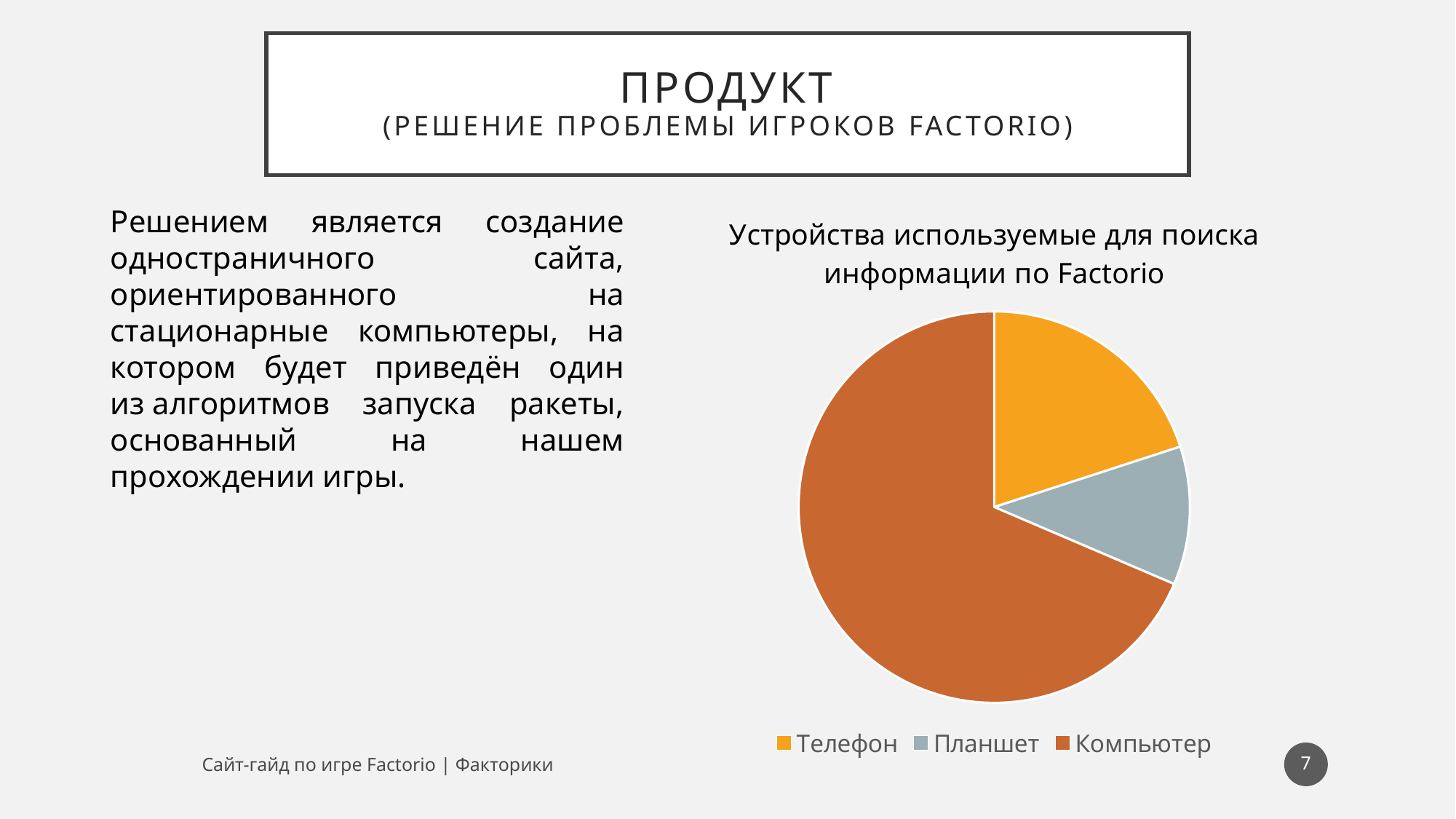
Which colour represents Компьютер in the pie chart? Brown/orange-brown Which category has the largest slice of the pie? Компьютер Which slice is larger, Компьютер or Телефон? Компьютер Which slice is larger, Телефон or Планшет? Телефон What is the title of the chart? Устройства используемые для поиска информации по Factorio How many categories (slices) does the pie chart have? 3 How many entries does the chart legend list? 3 What kind of chart is shown on the slide? Pie chart Which category has the smallest slice of the pie? Планшет Does the Компьютер slice take up more or less than half of the pie? More